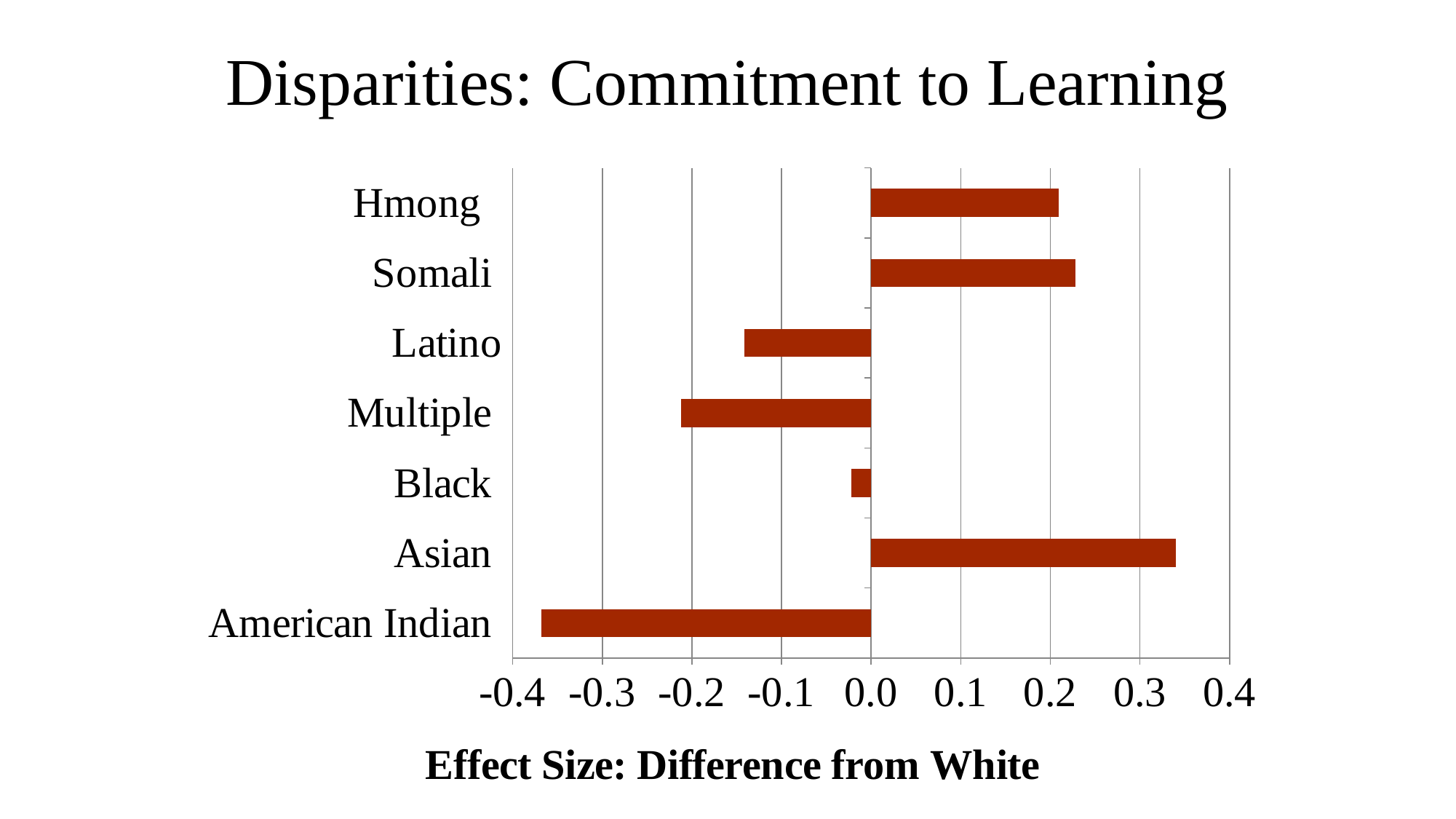
How many groups are plotted in the chart? 7 Which has the lower value, Multiple or Latino? Multiple Is the value for Somali greater or less than 0.1? greater Is the value for Multiple greater or less than -0.1? less Is the value for American Indian greater or less than -0.3? less How many groups have a positive effect size? 3 What kind of chart is shown on the slide? Bar chart Which has the larger value, Asian or Hmong? Asian Which group has the highest effect size? Asian Which group has the lowest effect size? American Indian